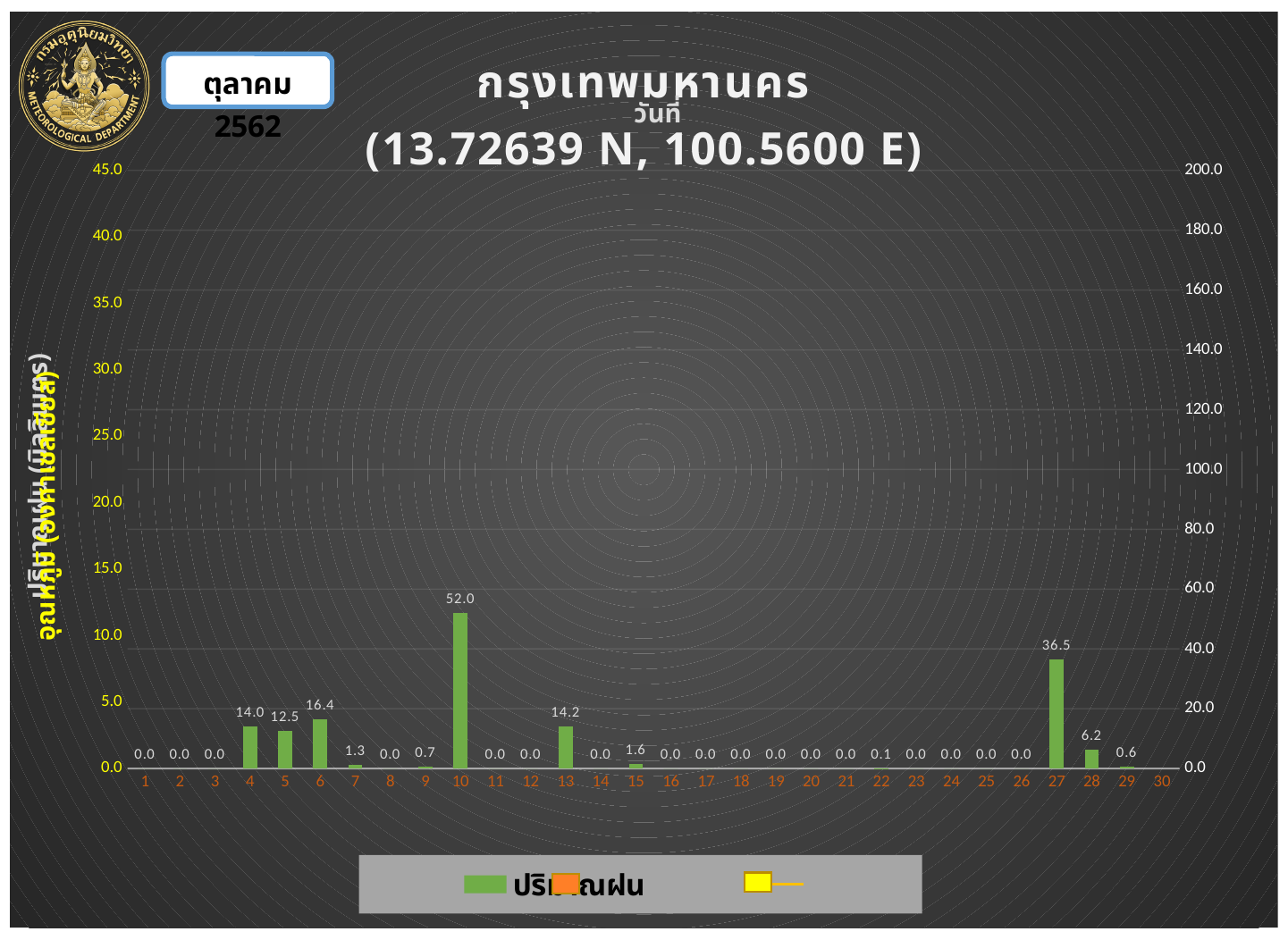
How many days are shown on the x axis? 30 What is the value shown for day 27? 36.5 What is the difference between the values for day 6 and day 4? 2.4 What coordinates are given in the chart title? 13.72639 N, 100.5600 E Which is larger, the value for day 4 or the value for day 5? day 4 What is the value shown for day 10? 52.0 What kind of chart is shown on the slide? bar chart What is the value shown for day 6? 16.4 What is the difference between the values for day 10 and day 27? 15.5 Is the value for day 10 greater or less than 40.0 on the right-hand axis? greater What is the value shown for day 13? 14.2 Which day has the highest value? 10